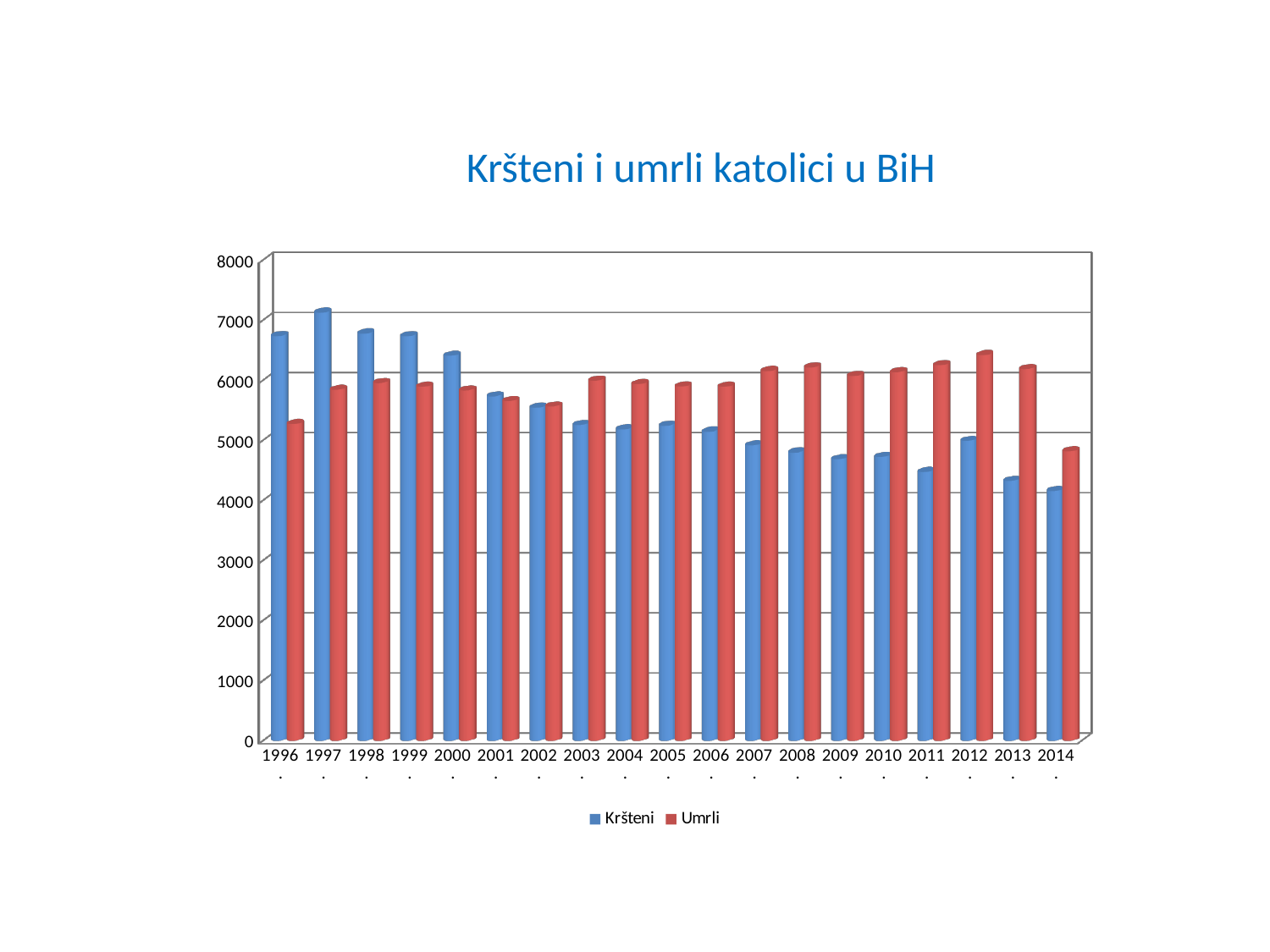
In which year is the Umrli value lowest? 2014 How many years are shown on the x axis? 19 What is the title of the chart? Kršteni i umrli katolici u BiH Is the Umrli value for 2014 greater or less than 5000? less Is the Kršteni value for 2014 greater or less than 4000? greater How many series does the legend list? 2 In which year is the Kršteni value highest? 1997 In 2012, which is larger, Kršteni or Umrli? Umrli Do the Kršteni values generally rise or fall from 1996 to 2014? fall In 1996, which is larger, Kršteni or Umrli? Kršteni What kind of chart is shown on the slide? bar chart Is the Kršteni value for 1997 greater or less than 7000? greater